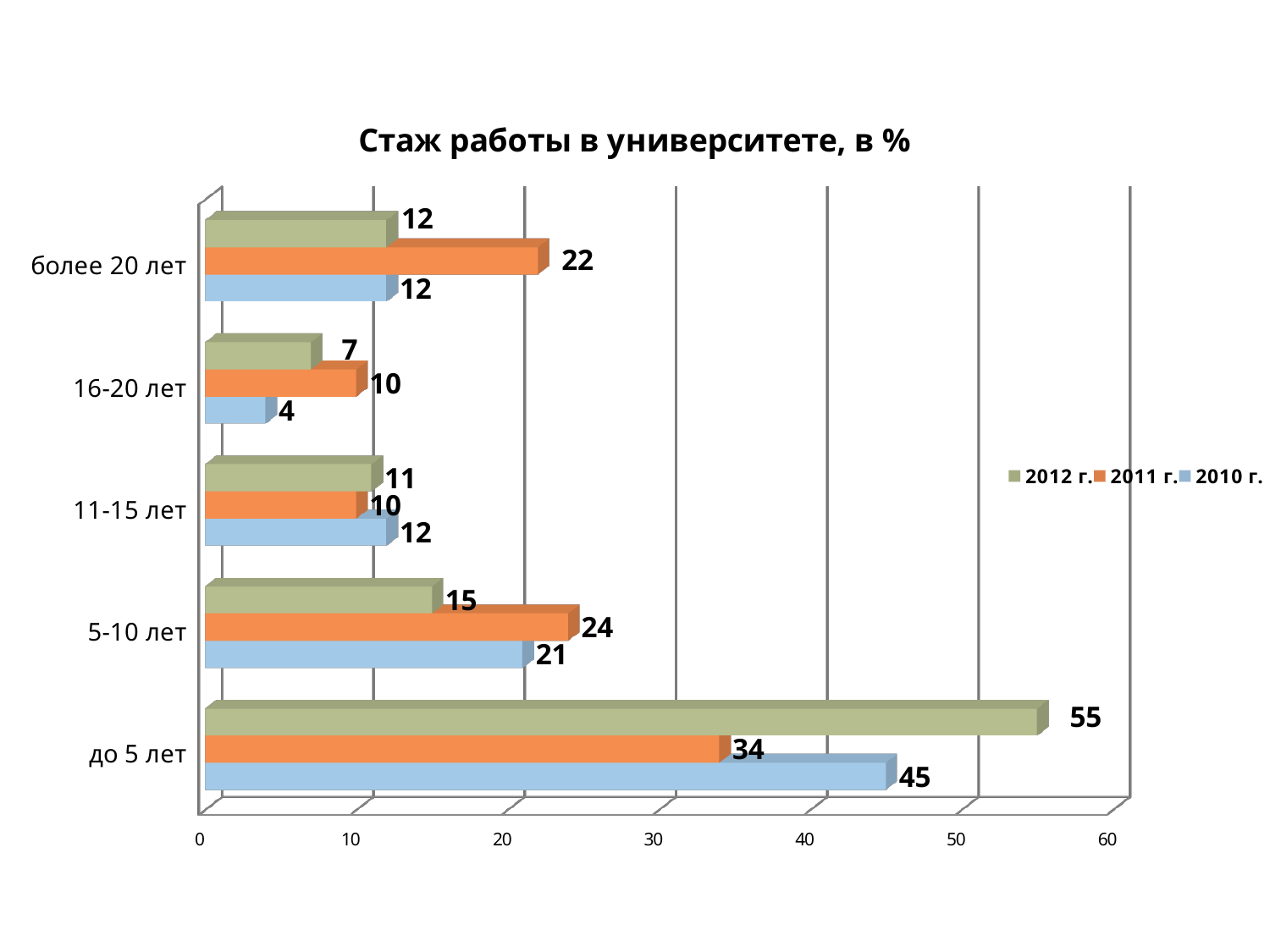
Which category has the highest value in the 2010 г. series? до 5 лет Which category has the lowest value in the 2012 г. series? 16-20 лет What is the value for "более 20 лет" in the 2011 г. series? 22 What kind of chart is shown on the slide? bar chart What is the value for "до 5 лет" in the 2012 г. series? 55 Which is larger for "5-10 лет": the 2011 г. value or the 2010 г. value? 2011 г. Is the value for "до 5 лет" in the 2010 г. series greater or less than 40? greater How many categories are shown on the chart? 5 What is the title of the chart? Стаж работы в университете, в % What is the difference between the 2012 г. and 2011 г. values for "до 5 лет"? 21 What is the value for "16-20 лет" in the 2010 г. series? 4 How many series does the legend list? 3